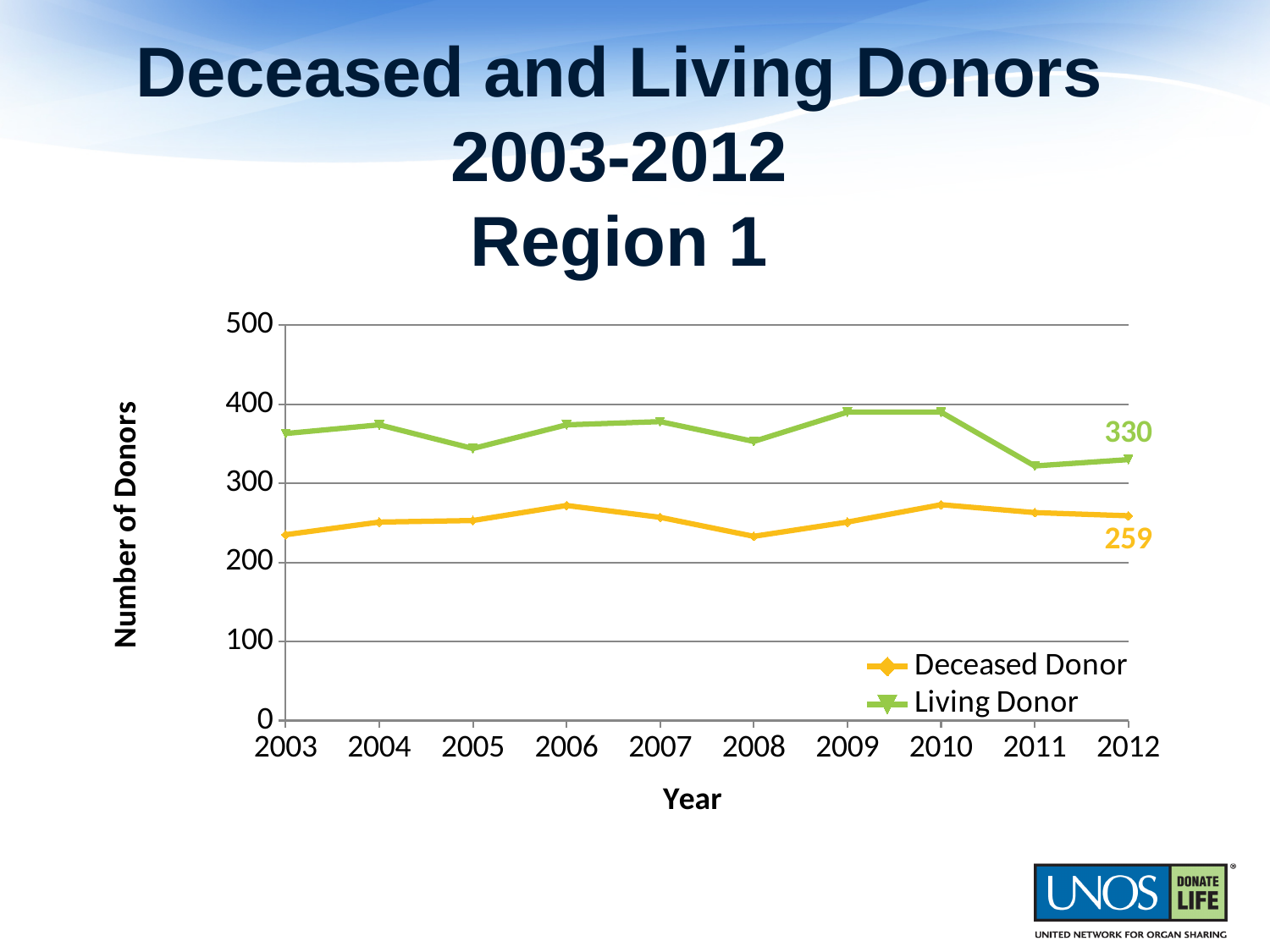
In 2012, which series has the larger value, Living Donor or Deceased Donor? Living Donor How many years are shown on the x axis? 10 How many series does the legend list? 2 What is the value for Deceased Donor in 2012? 259 Is the value for Living Donor in 2009 greater or less than 350? greater What kind of chart is shown on the slide? line chart What is the value for Living Donor in 2012? 330 Is the value for Living Donor in 2005 greater or less than 300? greater What is the title of the y axis? Number of Donors Is the value for Deceased Donor in 2008 greater or less than 300? less Does the Living Donor value rise or fall from 2010 to 2011? fall What is the difference between the Living Donor and Deceased Donor values in 2012? 71